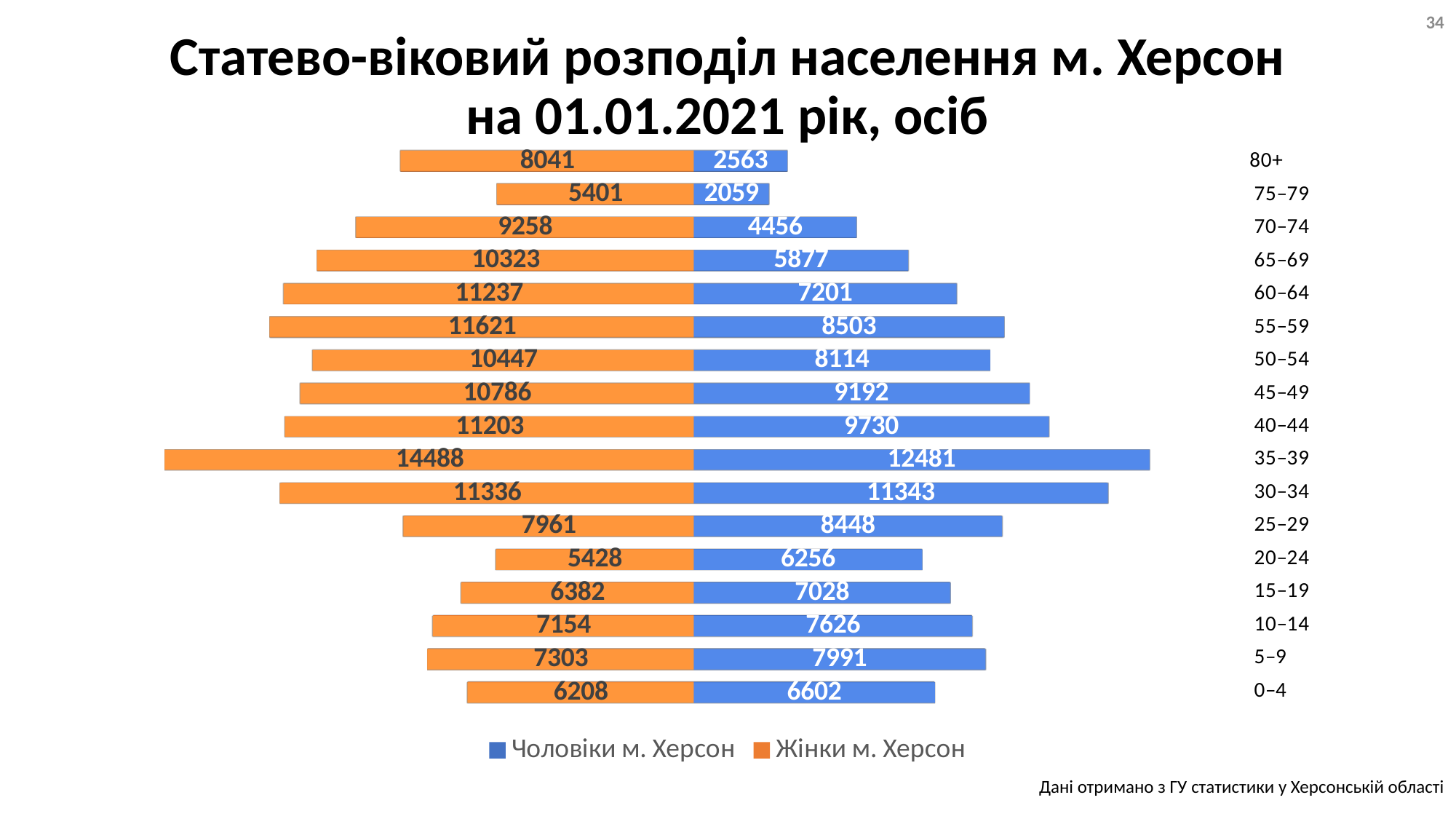
What is the number of women (Жінки м. Херсон) in the 35–39 age group? 14488 In the 20–24 age group, which is larger: the number of men or the number of women? Men What type of chart is shown on the slide? Bar chart What is the number of men (Чоловіки м. Херсон) in the 0–4 age group? 6602 What is the difference between the number of women and the number of men in the 35–39 age group? 2007 What is the number of men (Чоловіки м. Херсон) in the 80+ age group? 2563 What is the total population (men plus women) in the 0–4 age group? 12810 Which age group has the highest number of women (Жінки м. Херсон)? 35–39 How many series does the legend list? 2 How many age groups are shown in the chart? 17 In the 80+ age group, are there more men or more women? Women Which age group has the lowest number of men (Чоловіки м. Херсон)? 75–79